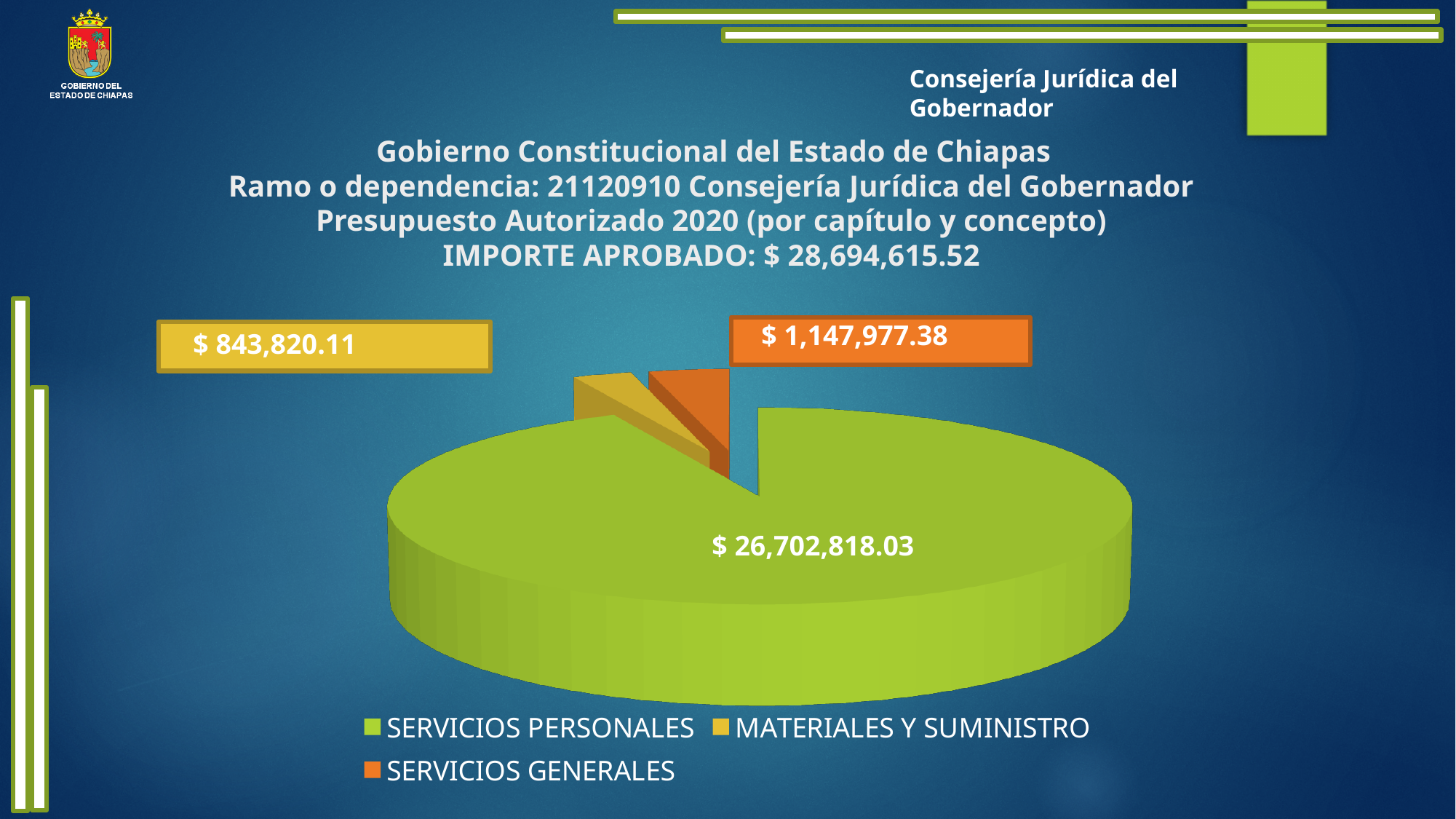
What is the value for MATERIALES Y SUMINISTRO? $ 843,820.11 What is the difference between SERVICIOS PERSONALES and SERVICIOS GENERALES? $ 25,554,840.65 What is the difference between SERVICIOS GENERALES and MATERIALES Y SUMINISTRO? $ 304,157.27 Which category has the smallest slice of the pie? MATERIALES Y SUMINISTRO Which category has the largest slice of the pie? SERVICIOS PERSONALES Which is larger, SERVICIOS GENERALES or MATERIALES Y SUMINISTRO? SERVICIOS GENERALES What is the total of all three slices of the pie chart? $ 28,694,615.52 Which colour represents SERVICIOS GENERALES in the legend? Orange What type of chart is shown on the slide? Pie chart How many categories does the pie chart have? 3 What is the value for SERVICIOS GENERALES? $ 1,147,977.38 What is the value for SERVICIOS PERSONALES? $ 26,702,818.03